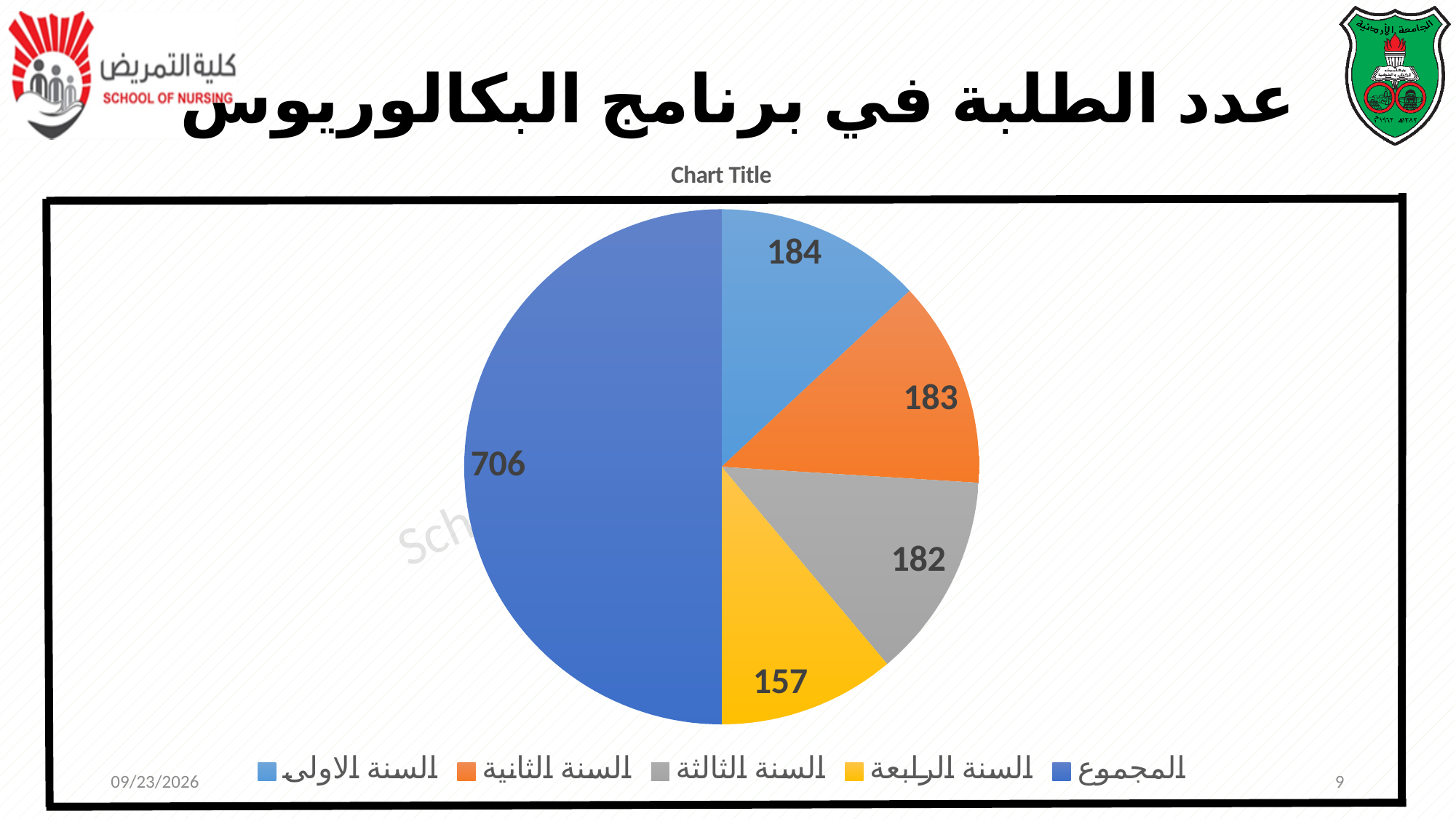
What type of chart is shown on the slide? pie chart What is the value for السنة الرابعة in the pie chart? 157 What is the value for المجموع in the pie chart? 706 Which slice of the pie chart has the largest value? المجموع How many slices does the pie chart have? 5 What is the difference between the values for السنة الاولى and السنة الرابعة? 27 What is the value for السنة الاولى in the pie chart? 184 Which slice of the pie chart has the smallest value? السنة الرابعة What is the value for السنة الثانية in the pie chart? 183 What is the value for السنة الثالثة in the pie chart? 182 Which is larger, the value for السنة الثانية or the value for السنة الرابعة? السنة الثانية What is the title shown above the pie chart? Chart Title